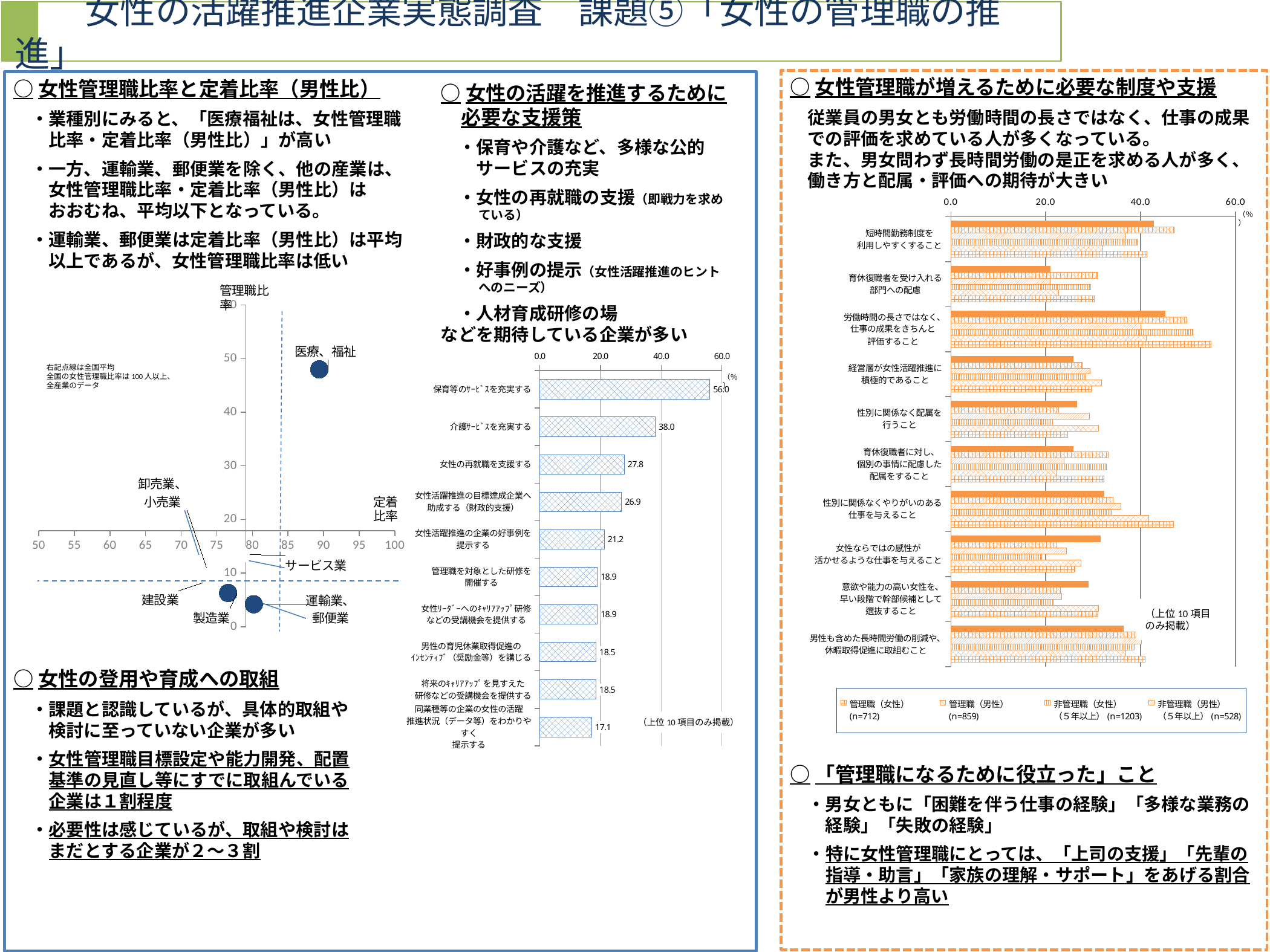
In the middle bar chart (必要な支援策), what is the value for 女性の再就職を支援する? 27.8 How many categories are shown in the middle bar chart (必要な支援策)? 10 In the middle bar chart (必要な支援策), what is the value for 介護サービスを充実する? 38.0 What kind of chart is the chart on the left showing 管理職比率 and 定着比率? Scatter chart In the right-hand bar chart (必要な制度や支援), is the 管理職（女性） value for 労働時間の長さではなく、仕事の成果をきちんと評価すること greater or less than 40.0? greater In the middle bar chart (必要な支援策), which category has the highest value? 保育等のサービスを充実する In the middle bar chart (必要な支援策), which is larger: 女性活躍推進の企業の好事例を提示する or 管理職を対象とした研修を開催する? 女性活躍推進の企業の好事例を提示する In the middle bar chart (必要な支援策), which category has the lowest value? 同業種等の企業の女性の活躍推進状況（データ等）をわかりやすく提示する How many series does the legend of the right-hand bar chart (必要な制度や支援) list? 4 In the middle bar chart (必要な支援策), what is the value for 保育等のサービスを充実する? 56.0 In the left scatter chart, which industry has the highest 管理職比率? 医療、福祉 In the middle bar chart (必要な支援策), what is the difference between 保育等のサービスを充実する and 介護サービスを充実する? 18.0